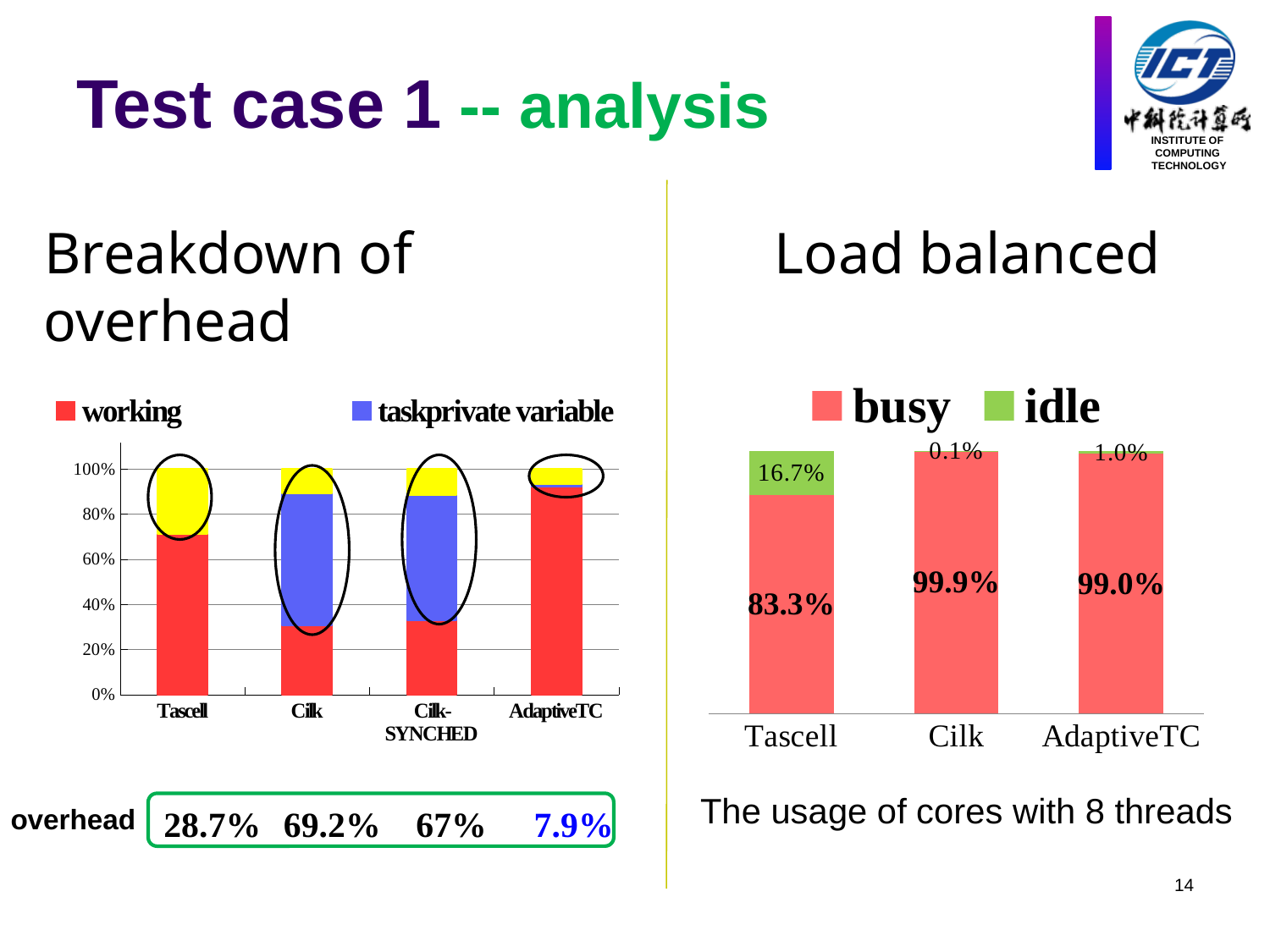
In the Breakdown of overhead chart, which category has the largest working share? AdaptiveTC In the Load balanced chart, what is the busy value for Tascell? 83.3% How many series does the legend of the Load balanced chart list? 2 In the Load balanced chart, what is the busy value for AdaptiveTC? 99.0% In the Load balanced chart, which category has the lowest busy value? Tascell In the Load balanced chart, what is the difference between the busy values for Cilk and AdaptiveTC? 0.9% In the overhead row below the Breakdown of overhead chart, what is the overhead value for AdaptiveTC? 7.9% In the Load balanced chart, what is the idle value for Tascell? 16.7% What kind of chart is the Breakdown of overhead chart? stacked bar chart In the Breakdown of overhead chart, is the working value for Cilk greater or less than 40%? less In the Load balanced chart, which category has the highest idle value? Tascell How many categories are shown in the Breakdown of overhead chart? 4